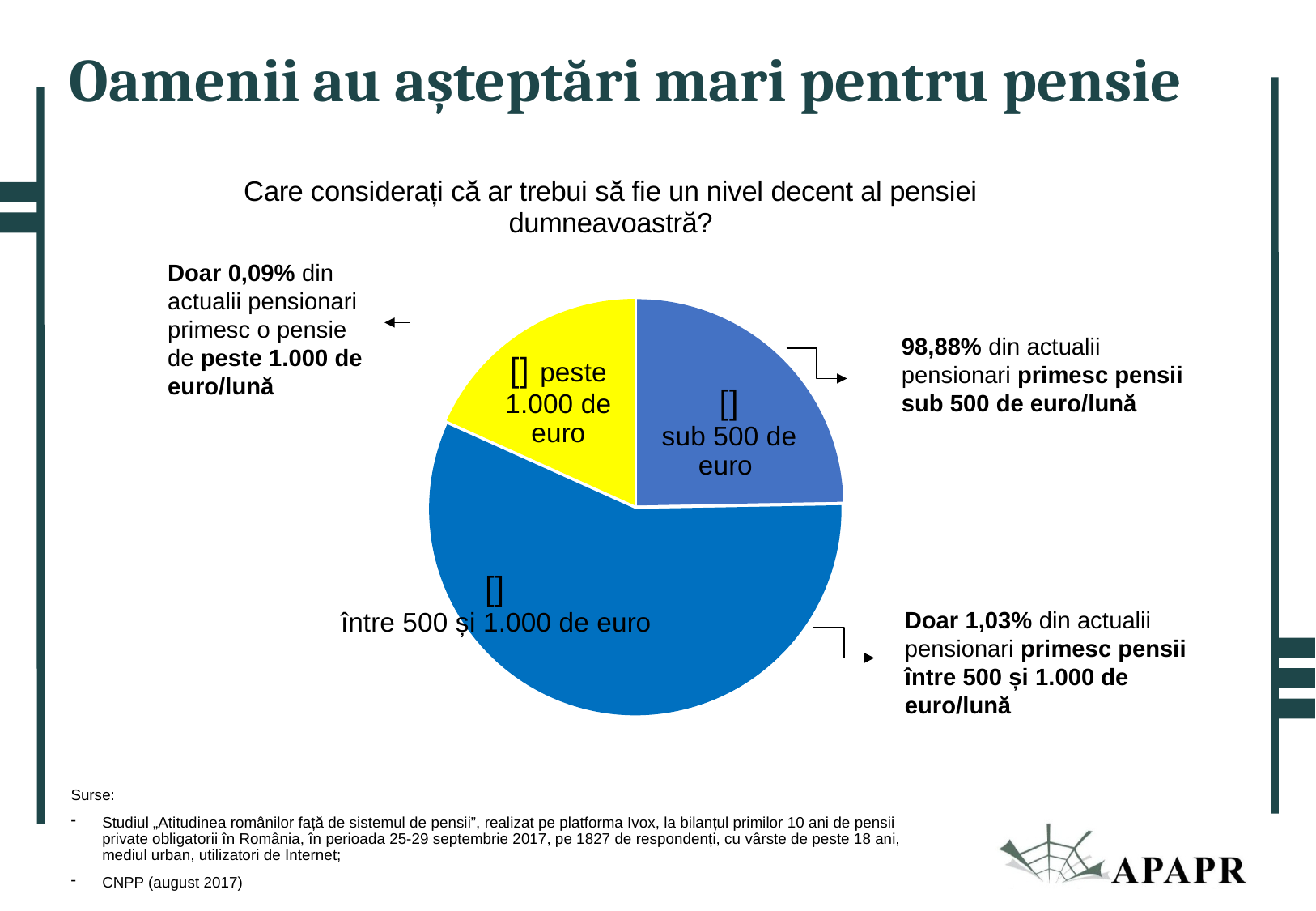
Does the 'între 500 și 1.000 de euro' slice cover more or less than half of the pie? more What colour is the 'peste 1.000 de euro' slice? yellow How many slices does the pie chart have? 3 What kind of chart is shown on the slide? pie chart Which slice is larger: 'între 500 și 1.000 de euro' or 'sub 500 de euro'? între 500 și 1.000 de euro Which slice of the pie chart is the smallest? peste 1.000 de euro Which slice of the pie chart is the largest? între 500 și 1.000 de euro Which slice is larger: 'sub 500 de euro' or 'peste 1.000 de euro'? sub 500 de euro What survey question is the pie chart answering? Care considerați că ar trebui să fie un nivel decent al pensiei dumneavoastră?